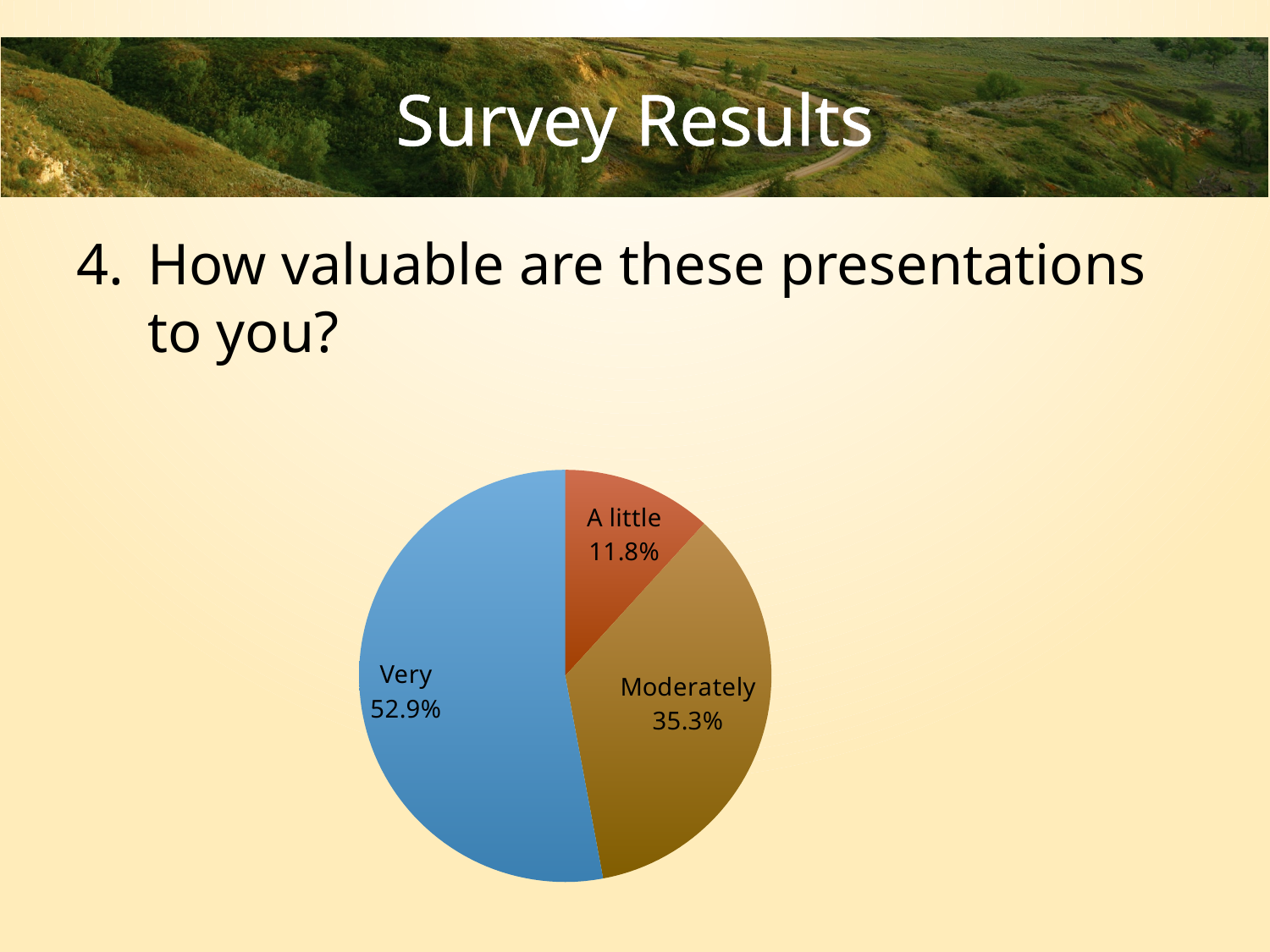
What colour is the "Very" slice of the pie chart? blue How many slices does the pie chart have? 3 What is the difference in percentage points between the "Moderately" and "A little" slices? 23.5 What percentage of respondents said the presentations are "Moderately" valuable? 35.3% Which response has the smallest share of the pie? A little Which slice is larger, "Moderately" or "A little"? Moderately Which response has the largest share of the pie? Very What share of the pie does the "Very" slice represent? 52.9% What percentage of respondents said the presentations are "Very" valuable? 52.9% What percentage of respondents said the presentations are "A little" valuable? 11.8% What is the difference in percentage points between the "Very" and "Moderately" slices? 17.6 What kind of chart is shown on the slide? pie chart